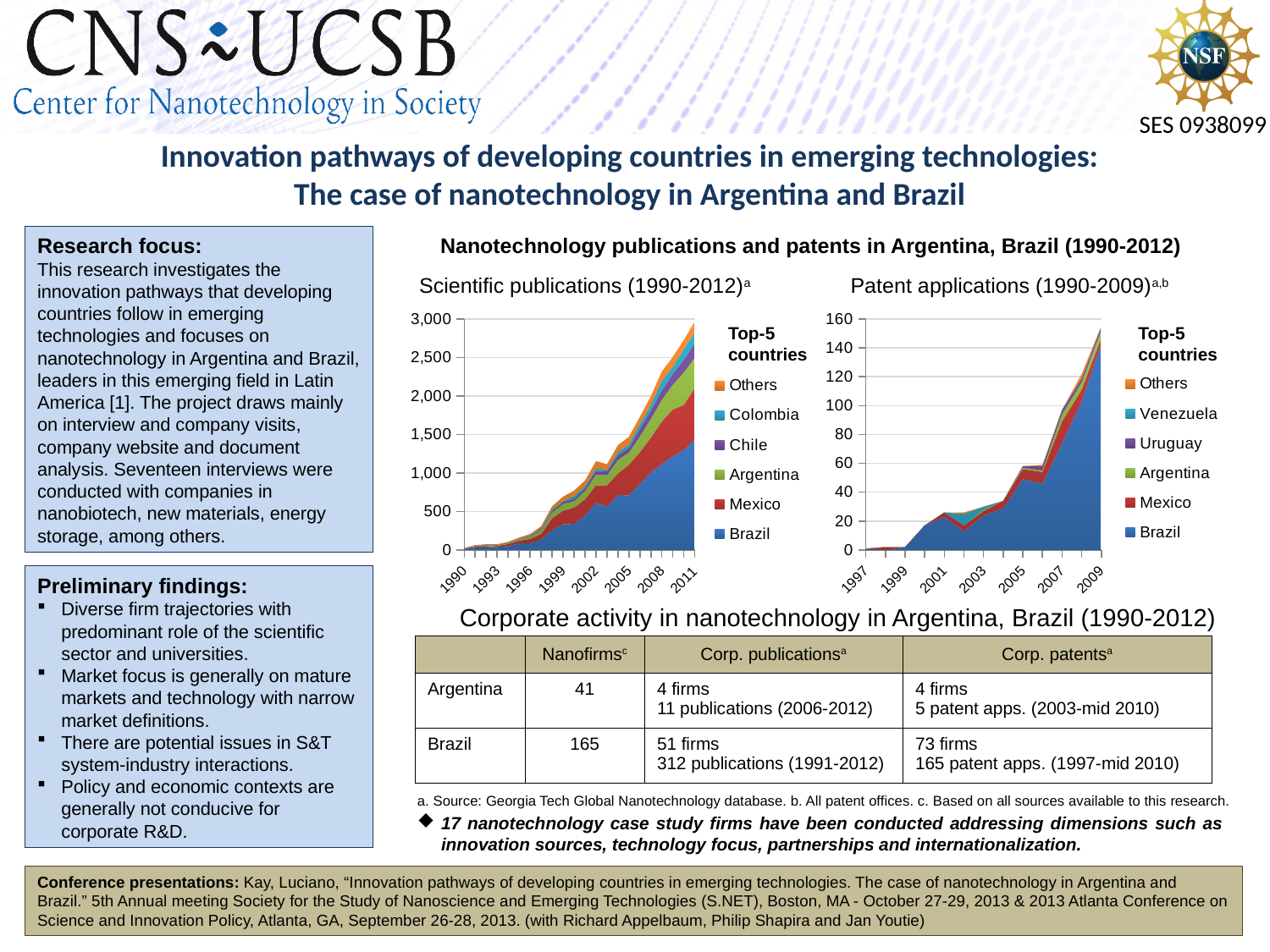
What kind of chart is the 'Scientific publications (1990-2012)' chart? stacked area chart What is the overall title above the two charts? Nanotechnology publications and patents in Argentina, Brazil (1990-2012) In the 'Scientific publications (1990-2012)' chart, is the total stacked value in 2011 greater or less than 2,500? greater In the 'Patent applications (1990-2009)' chart, is the total stacked value in 2009 greater or less than 140? greater Which series appears in the legend of the 'Patent applications (1990-2009)' chart but not in the legend of the 'Scientific publications (1990-2012)' chart? Venezuela and Uruguay How many series does the legend of the 'Scientific publications (1990-2012)' chart list? 6 How many series does the legend of the 'Patent applications (1990-2009)' chart list? 6 In the 'Scientific publications (1990-2012)' chart, is the value for Brazil in 2011 greater or less than 1,000? greater What kind of chart is the 'Patent applications (1990-2009)' chart? stacked area chart In the 'Patent applications (1990-2009)' chart, do the total patent applications rise or fall from 1997 to 2009? rise In the 'Scientific publications (1990-2012)' chart, do the total publications rise or fall from 1990 to 2011? rise